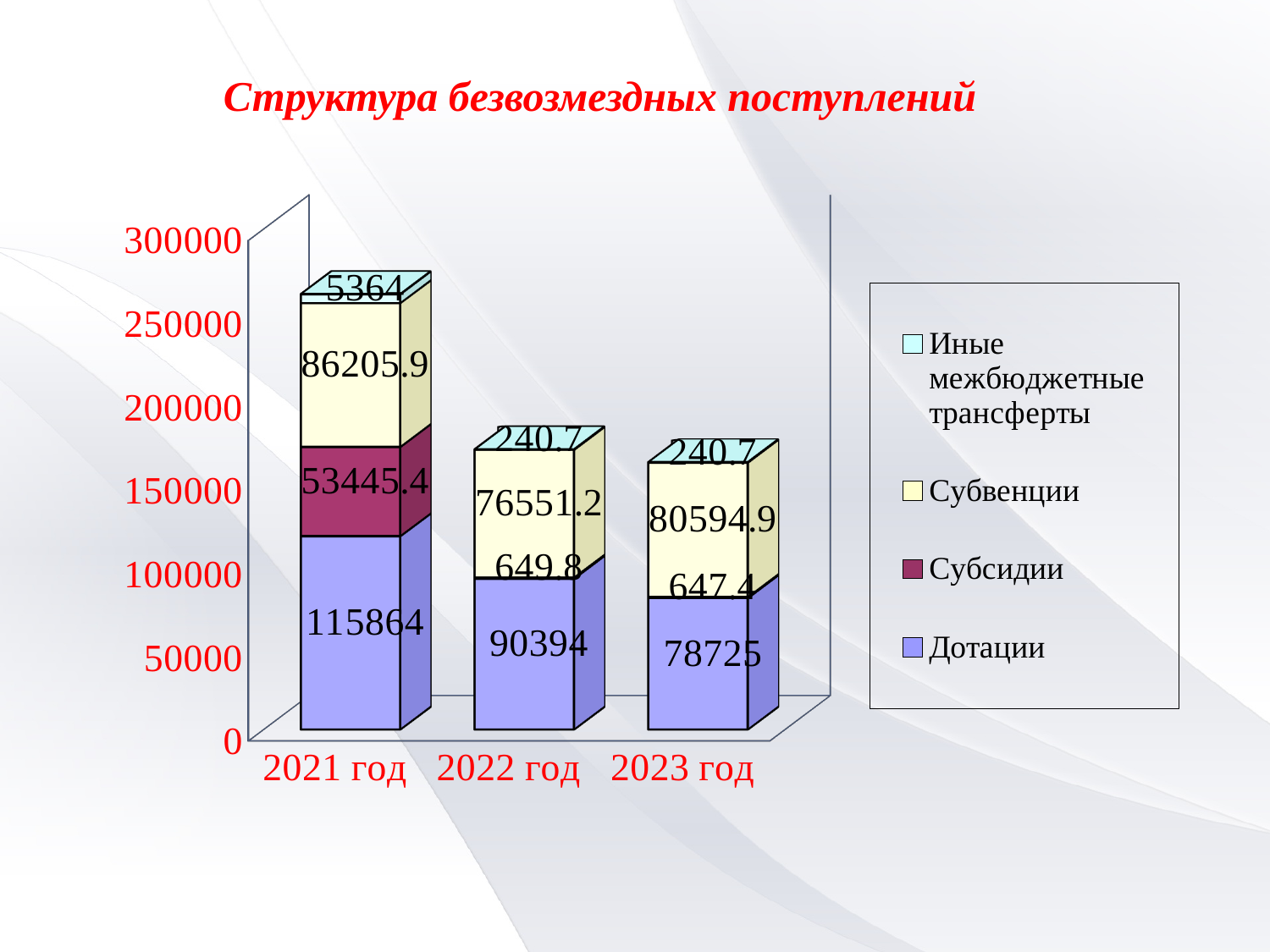
Which year has the highest value of Дотации? 2021 год Which is larger: Субвенции in 2022 год or Субвенции in 2023 год? Субвенции in 2023 год How many series does the legend list? 4 What is the value of Дотации for 2021 год? 115864 What is the difference between Дотации in 2021 год and 2022 год? 25470 What is the value of Субсидии for 2022 год? 649.8 What is the total of the stacked bar for 2023 год? 160208 Which year has the lowest value of Субвенции? 2022 год Does the value of Дотации rise or fall from 2021 год to 2023 год? Fall What type of chart is shown on the slide? Stacked bar chart What is the value of Иные межбюджетные трансферты for 2021 год? 5364 What is the value of Субвенции for 2023 год? 80594.9